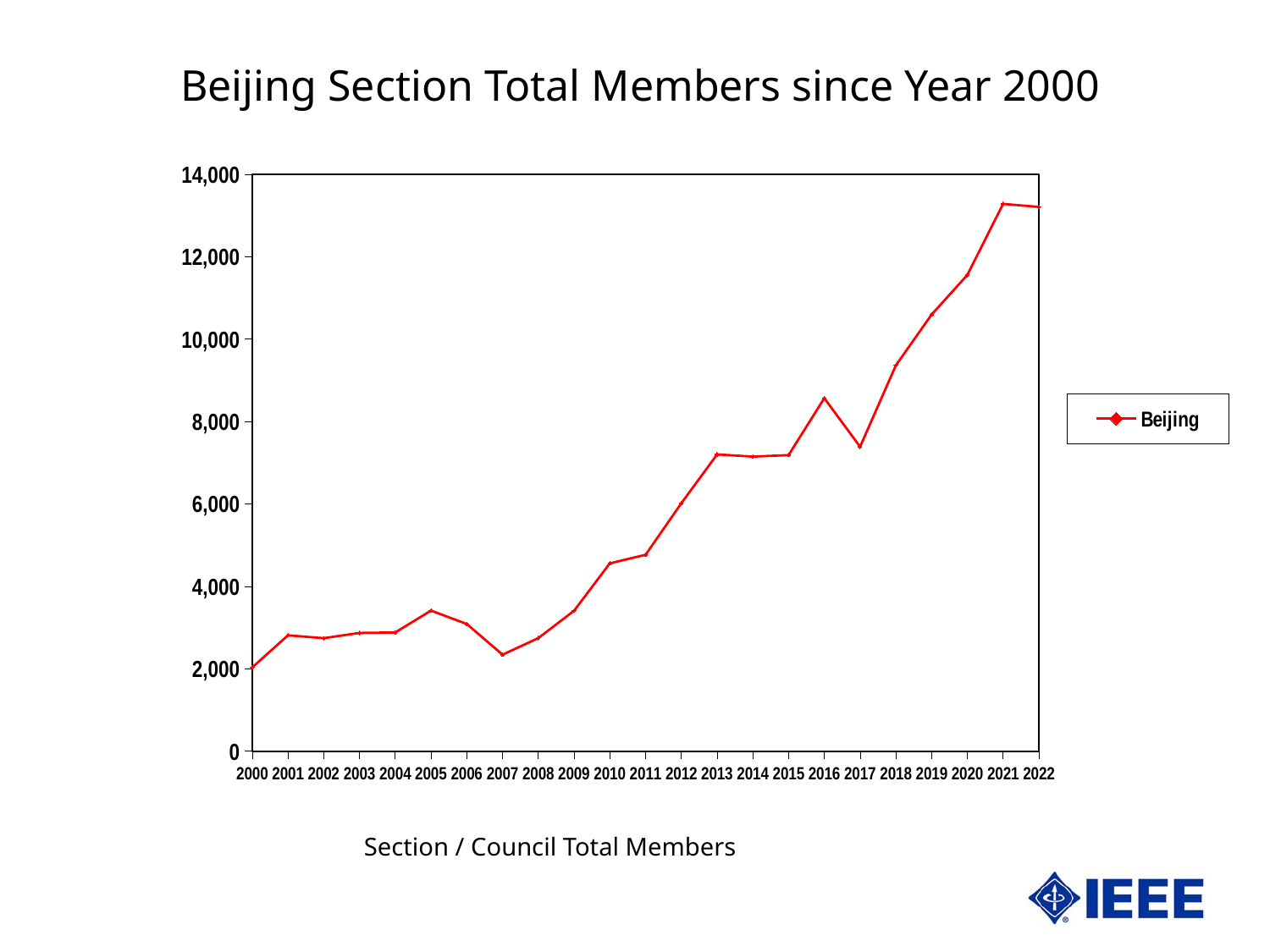
What is the name of the series shown in the legend? Beijing Which year has the lowest number of Beijing Section members? 2000 Is the value for 2019 greater or less than 10,000? greater Overall, do the values rise or fall from 2000 to 2022? rise How many years are plotted along the x axis? 23 Which year has the larger value, 2005 or 2007? 2005 Which year has the larger value, 2016 or 2017? 2016 Is the value for 2020 greater or less than 12,000? less Is the value for 2017 greater or less than 8,000? less What kind of chart is shown on the slide? line chart How many series does the legend list? 1